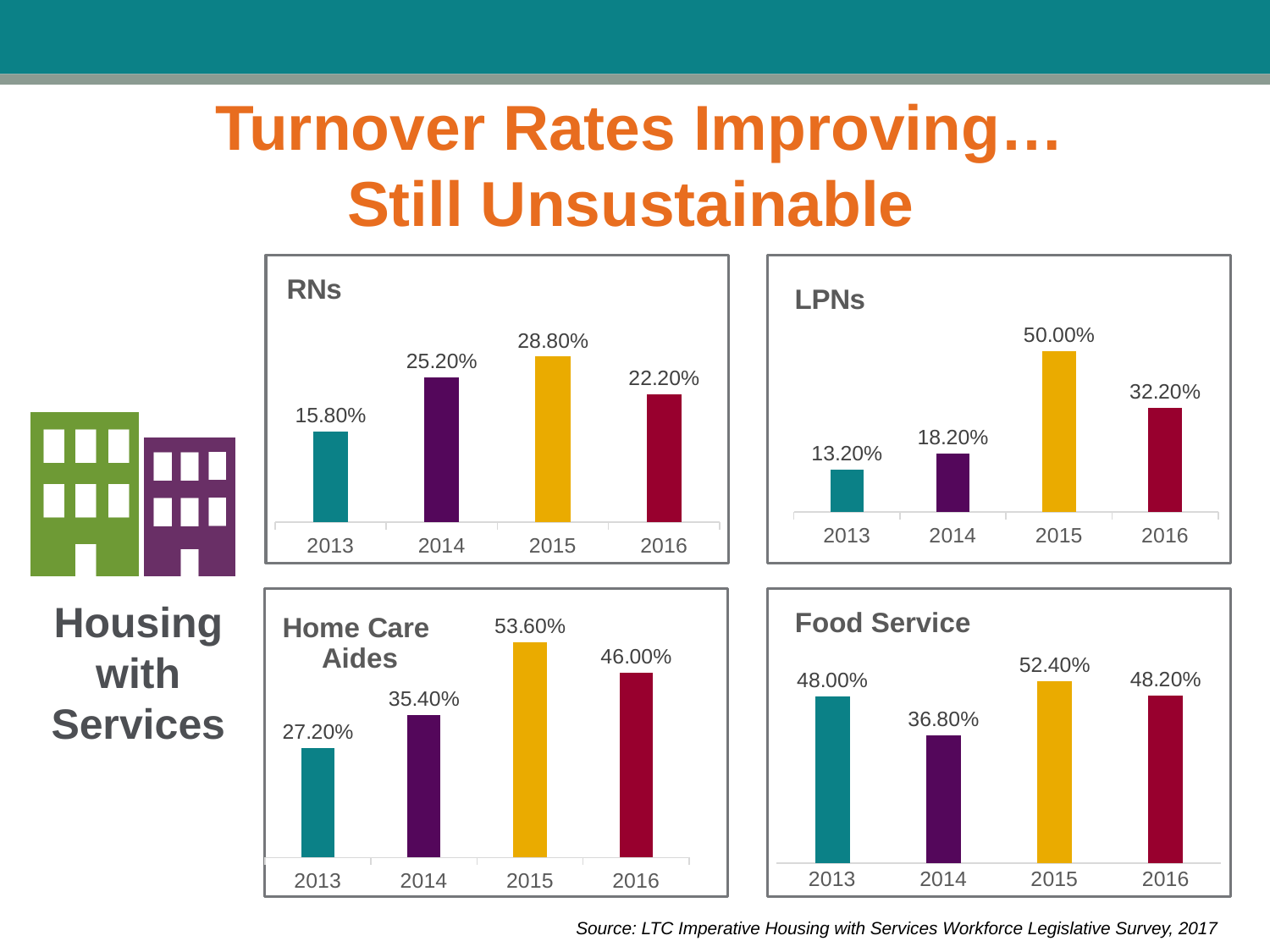
In the RNs chart, do the values rise or fall from 2013 to 2015? Rise In the LPNs chart, what is the value for 2013? 13.20% What kind of chart is the Food Service chart? Bar chart In the RNs chart, what is the turnover rate for 2015? 28.80% In the RNs chart, which year has the lowest turnover rate? 2013 In the Home Care Aides chart, what is the difference between the 2015 and 2014 values? 18.20% In the Home Care Aides chart, what is the value for 2016? 46.00% In the LPNs chart, which year has the highest turnover rate? 2015 How many charts are shown on the slide? 4 In the Food Service chart, which is larger, the value for 2013 or the value for 2016? 2016 In the Food Service chart, what is the value for 2014? 36.80% How many years are shown in the LPNs chart? 4